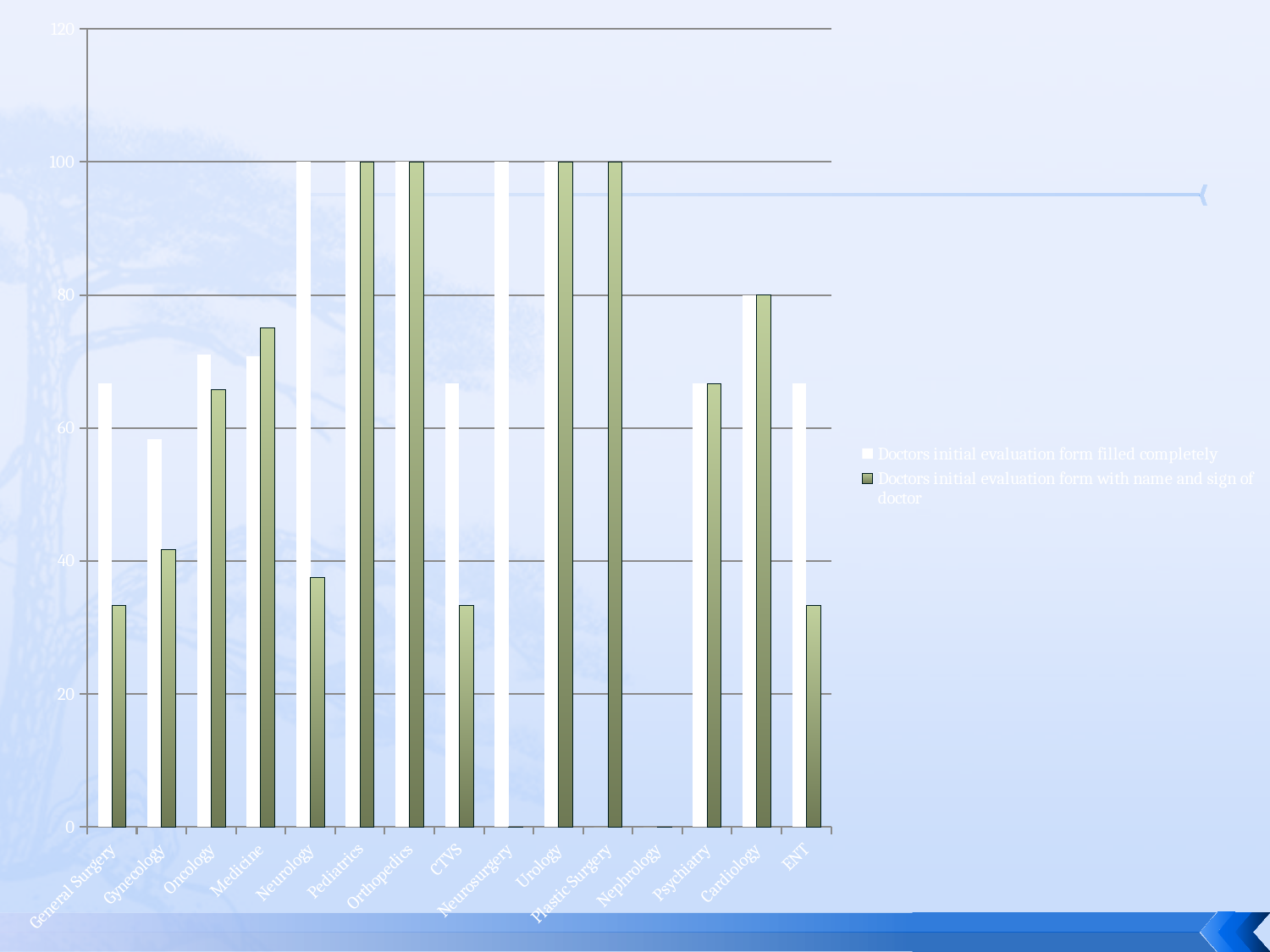
Which department has the lowest value in the 'Doctors initial evaluation form filled completely' series? Plastic Surgery and Nephrology (both 0) What is the value for Nephrology in the 'Doctors initial evaluation form filled completely' series? 0 How many departments are shown on the x axis? 15 For Neurology, which series has the larger value: 'Doctors initial evaluation form filled completely' or 'Doctors initial evaluation form with name and sign of doctor'? Doctors initial evaluation form filled completely Is the value for General Surgery in the 'Doctors initial evaluation form with name and sign of doctor' series greater or less than 40? less Is the value for Medicine in the 'Doctors initial evaluation form with name and sign of doctor' series greater or less than 80? less How many series does the legend list? 2 What is the value for Neurosurgery in the 'Doctors initial evaluation form with name and sign of doctor' series? 0 What is the value for Cardiology in the 'Doctors initial evaluation form with name and sign of doctor' series? 80 What is the value for Pediatrics in the 'Doctors initial evaluation form filled completely' series? 100 Is the value for Psychiatry in the 'Doctors initial evaluation form with name and sign of doctor' series greater or less than 60? greater What kind of chart is shown on the slide? bar chart